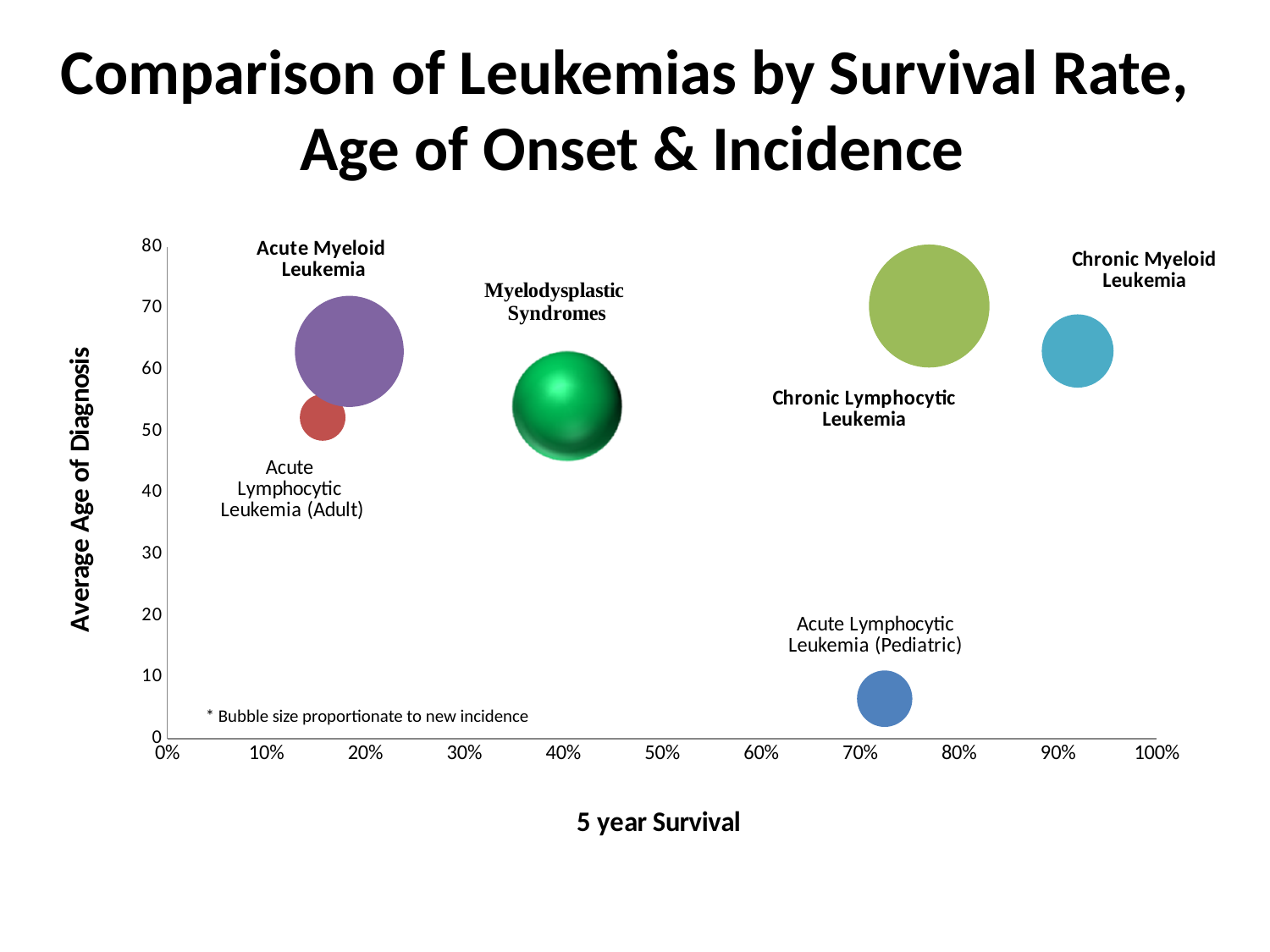
Which has a higher average age of diagnosis: Acute Myeloid Leukemia or Acute Lymphocytic Leukemia (Adult)? Acute Myeloid Leukemia Is the average age of diagnosis for Acute Lymphocytic Leukemia (Pediatric) greater or less than 10? less What kind of chart is shown on the slide? bubble chart How many leukemia types (bubbles) are plotted on the chart? 6 What is the title of the horizontal axis? 5 year Survival Which leukemia type has the highest average age of diagnosis? Chronic Lymphocytic Leukemia According to the note on the chart, what is bubble size proportionate to? new incidence Is the 5 year survival for Acute Lymphocytic Leukemia (Pediatric) greater or less than 60%? greater Which leukemia type has the lowest average age of diagnosis? Acute Lymphocytic Leukemia (Pediatric) Which leukemia type has the highest 5 year survival rate? Chronic Myeloid Leukemia Is the 5 year survival for Acute Myeloid Leukemia greater or less than 30%? less Which has a higher 5 year survival rate: Chronic Lymphocytic Leukemia or Myelodysplastic Syndromes? Chronic Lymphocytic Leukemia